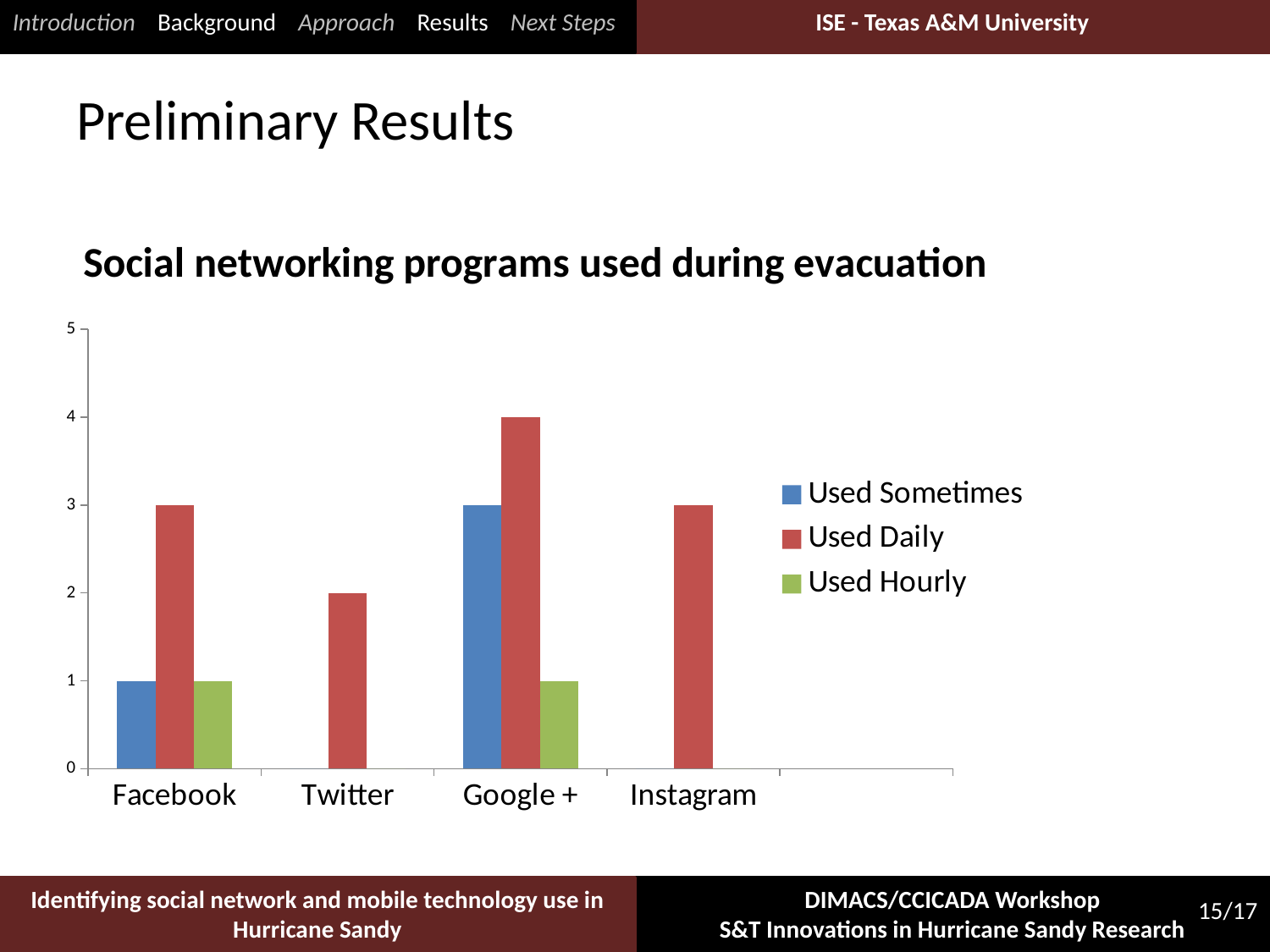
What is the Used Hourly value for Google +? 1 Which category has the lowest Used Daily value? Twitter What is the Used Daily value for Twitter? 2 What kind of chart is shown on the slide? Bar chart How many series does the legend list? 3 What is the Used Sometimes value for Facebook? 1 What is the Used Daily value for Google +? 4 Which category has the highest Used Daily value? Google + What is the difference between the Used Daily values for Google + and Twitter? 2 What is the title of the chart? Social networking programs used during evacuation Which is larger, the Used Sometimes value for Google + or the Used Sometimes value for Facebook? Google + Is the Used Daily value for Instagram greater or less than 2? greater